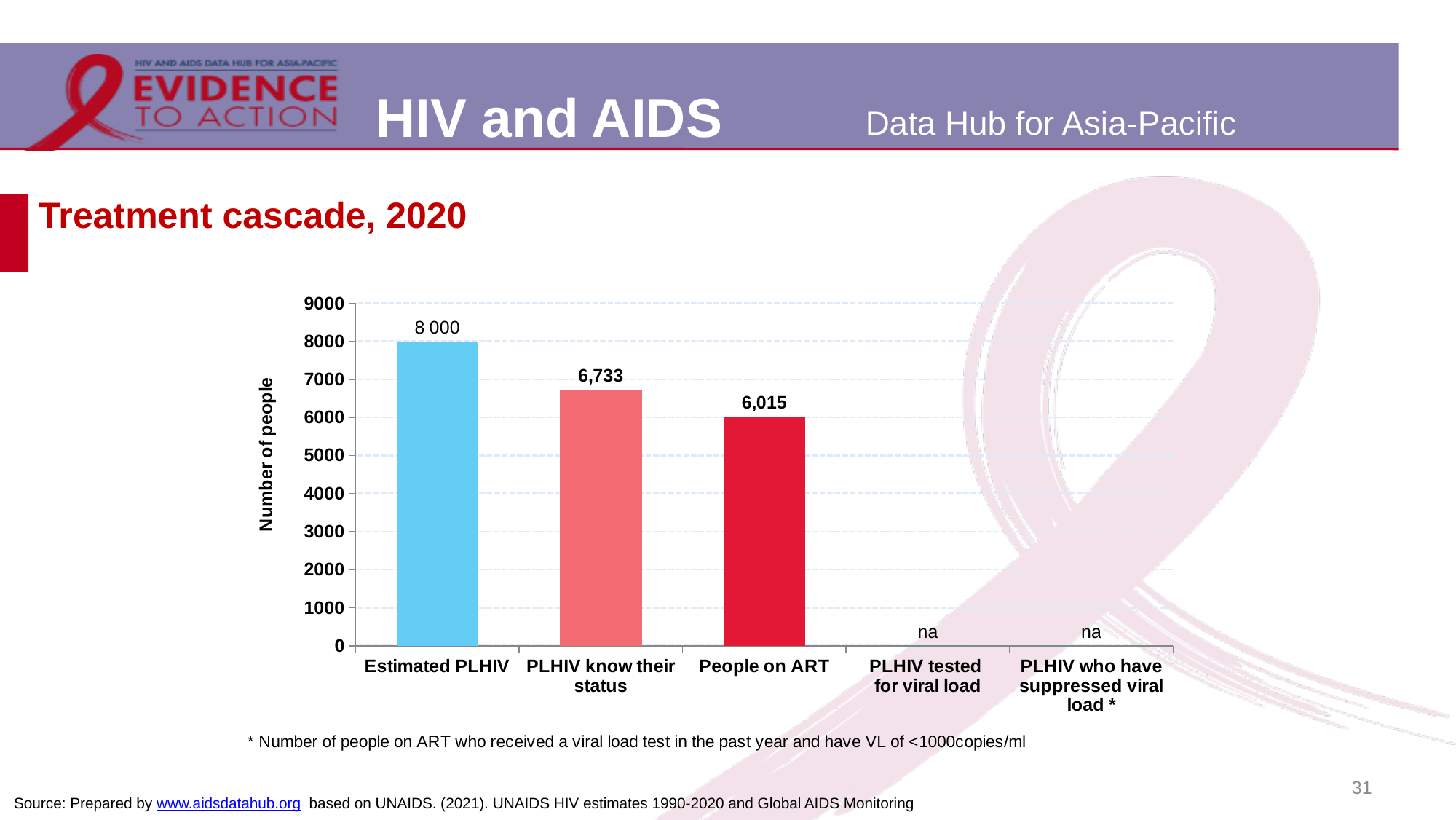
Among the categories with plotted bars, which has the lowest value? People on ART What is the value for PLHIV know their status? 6,733 Is the value for People on ART greater or less than 7000? less Which is larger, Estimated PLHIV or PLHIV know their status? Estimated PLHIV What is the value for People on ART? 6,015 How many categories are shown on the x axis? 5 What is the value for Estimated PLHIV? 8 000 What is the label of the y axis? Number of people Which category has the highest value? Estimated PLHIV What kind of chart is this? bar chart What is shown for PLHIV tested for viral load? na What is the difference between PLHIV know their status and People on ART? 718